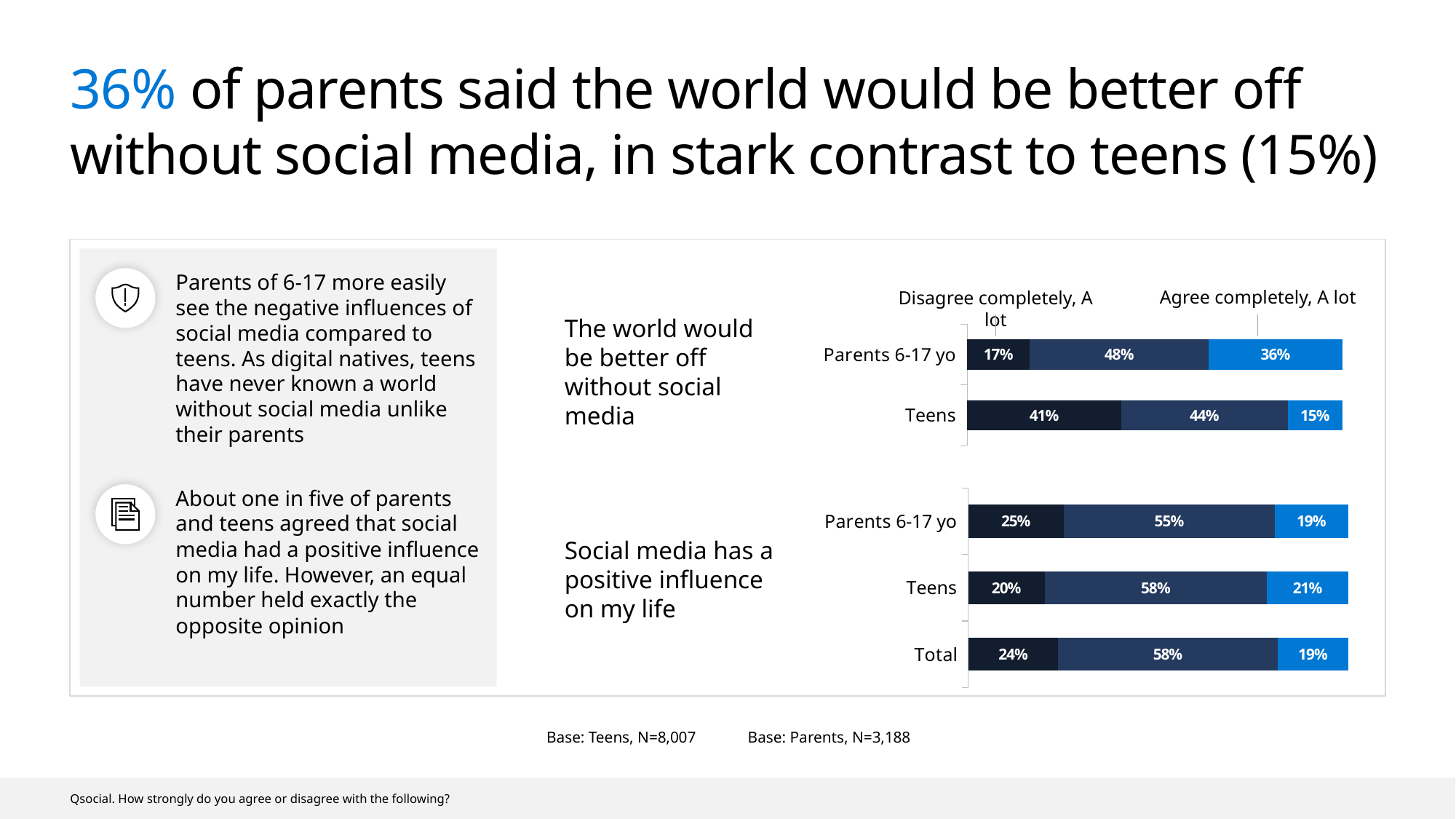
In the chart 'Social media has a positive influence on my life', which group has the largest 'Disagree completely, A lot' segment? Parents 6-17 yo How many bars are shown in the chart 'Social media has a positive influence on my life'? 3 In the chart 'Social media has a positive influence on my life', what percentage of the Total bar is in the 'Disagree completely, A lot' segment? 24% In the chart 'The world would be better off without social media', what percentage of Teens fall in the 'Disagree completely, A lot' segment? 41% What are the two legend labels shown above the charts? Disagree completely, A lot; Agree completely, A lot In the chart 'Social media has a positive influence on my life', what is the total of the three segments for the Total bar? 101% In the chart 'The world would be better off without social media', what percentage of Parents 6-17 yo fall in the 'Agree completely, A lot' segment? 36% In the chart 'The world would be better off without social media', what is the difference between the 'Agree completely, A lot' values for Parents 6-17 yo and Teens? 21 percentage points In the chart 'The world would be better off without social media', which group has the larger 'Disagree completely, A lot' segment, Parents 6-17 yo or Teens? Teens In the chart 'Social media has a positive influence on my life', which group has the highest 'Agree completely, A lot' value? Teens In the chart 'Social media has a positive influence on my life', what is the value of the middle segment for Teens? 58% What type of chart is used to show the responses on this slide? Stacked bar chart